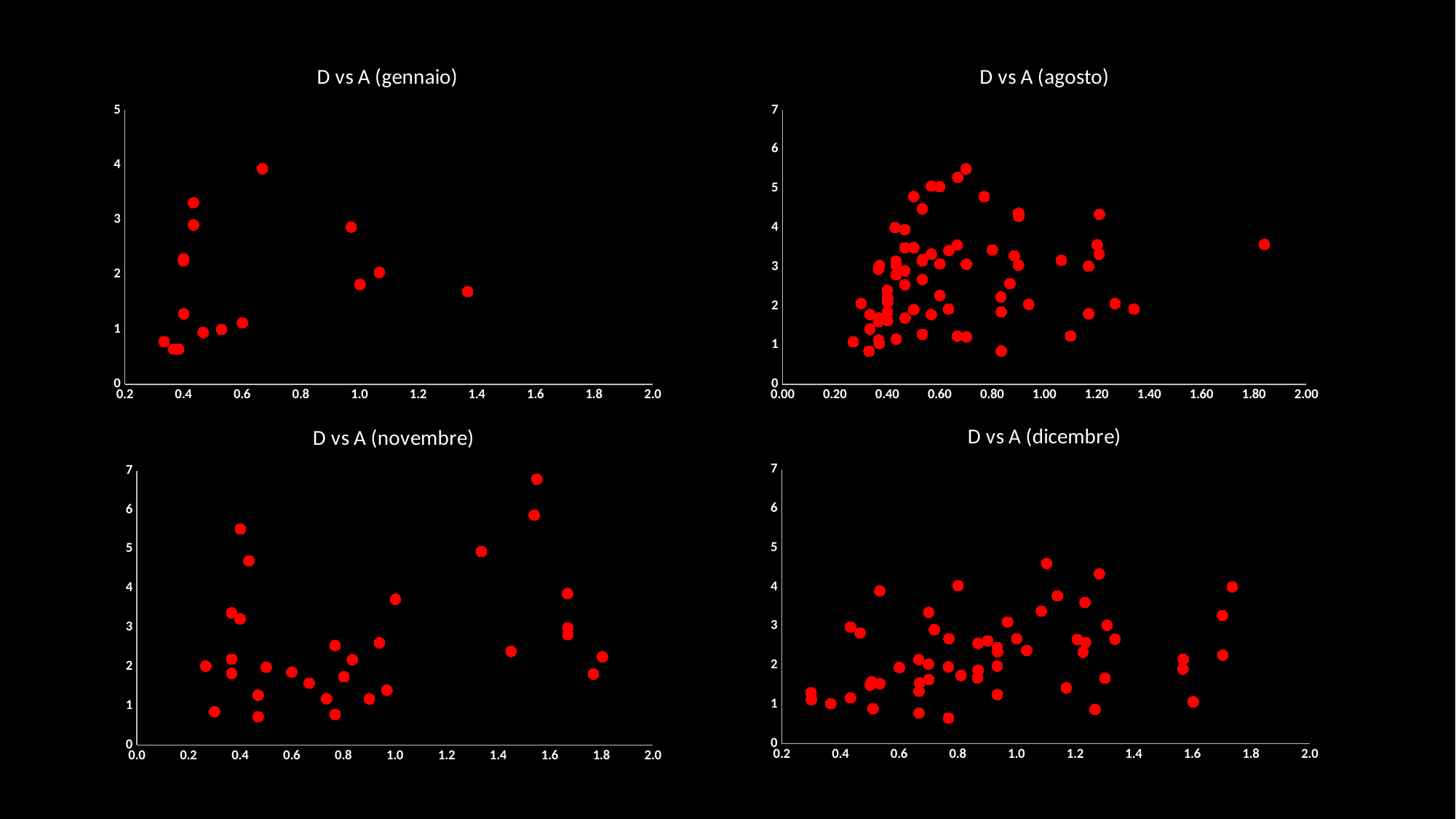
In D vs A (agosto), is the x value of the rightmost point greater or less than 1.60? greater In D vs A (dicembre), is the y value of the highest point greater or less than 5? less What is the title of the chart in the top-right position? D vs A (agosto) In D vs A (agosto), what is the maximum value shown on the y axis? 7 In D vs A (novembre), is the y value of the highest point greater or less than 6? greater In D vs A (gennaio), what is the maximum value shown on the y axis? 5 Which of the four charts has a y axis that goes up to only 5 rather than 7? D vs A (gennaio) What kind of chart is D vs A (gennaio)? scatter chart What is the title of the chart in the bottom-left position? D vs A (novembre) How many charts are shown on the slide? 4